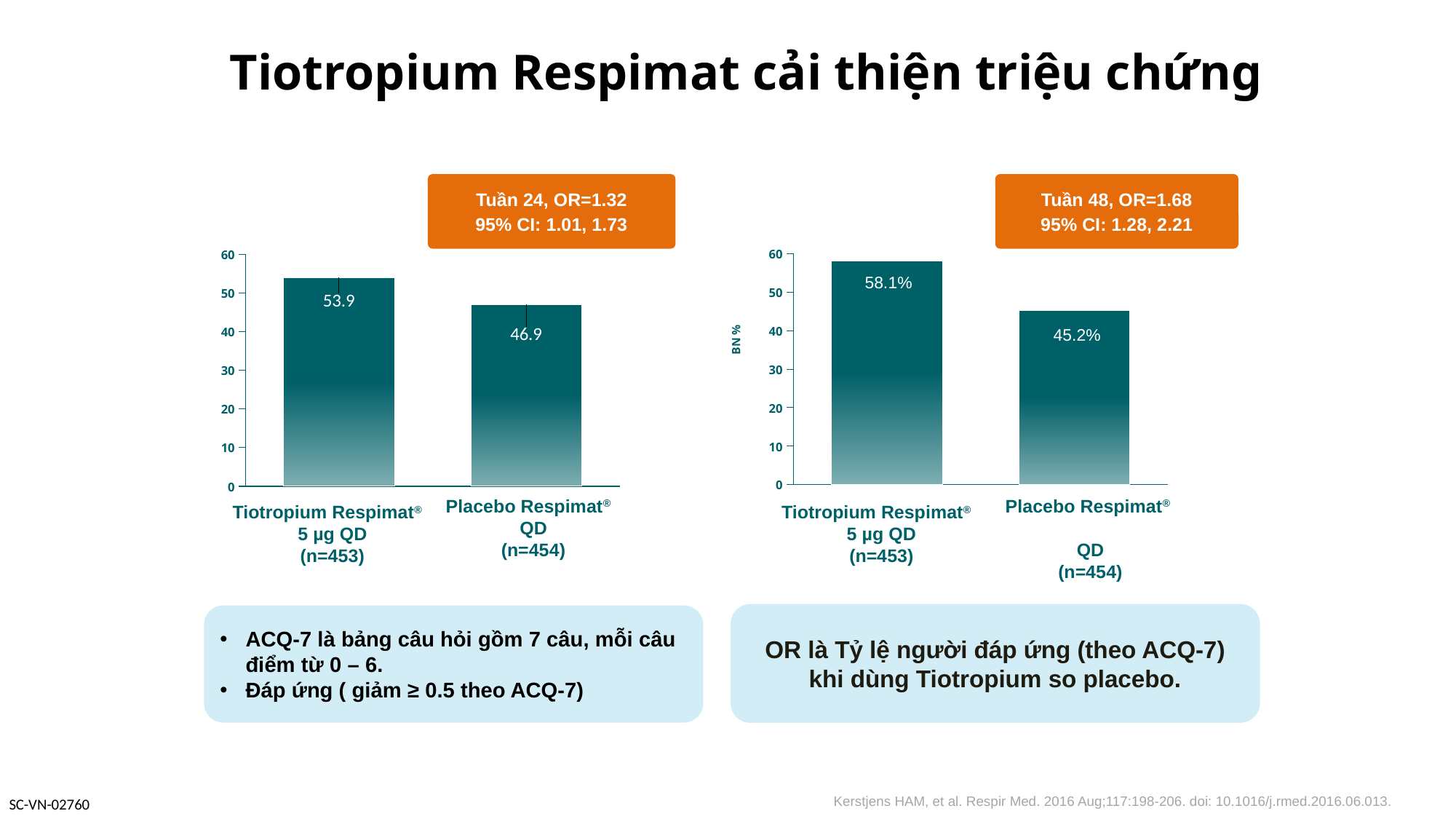
What type of chart is the right chart (Tuần 48)? Bar chart In the right chart (Tuần 48), what is the value for Tiotropium Respimat 5 µg QD (n=453)? 58.1% In the right chart (Tuần 48), is the value for Placebo Respimat greater or less than 50? less How many bars are shown in the left chart (Tuần 24)? 2 In the left chart (Tuần 24), what is the value for Tiotropium Respimat 5 µg QD (n=453)? 53.9 In the left chart (Tuần 24), which category has the lowest value? Placebo Respimat QD (n=454) In the left chart (Tuần 24), what is the value for Placebo Respimat QD (n=454)? 46.9 In the right chart (Tuần 48), what is the value for Placebo Respimat QD (n=454)? 45.2% In the right chart (Tuần 48), which bar is higher, Tiotropium Respimat or Placebo Respimat? Tiotropium Respimat What is the y-axis label of the right chart (Tuần 48)? BN % In the left chart (Tuần 24), what is the difference between the Tiotropium Respimat and Placebo Respimat values? 7.0 In the right chart (Tuần 48), what is the difference between the Tiotropium Respimat and Placebo Respimat values? 12.9%